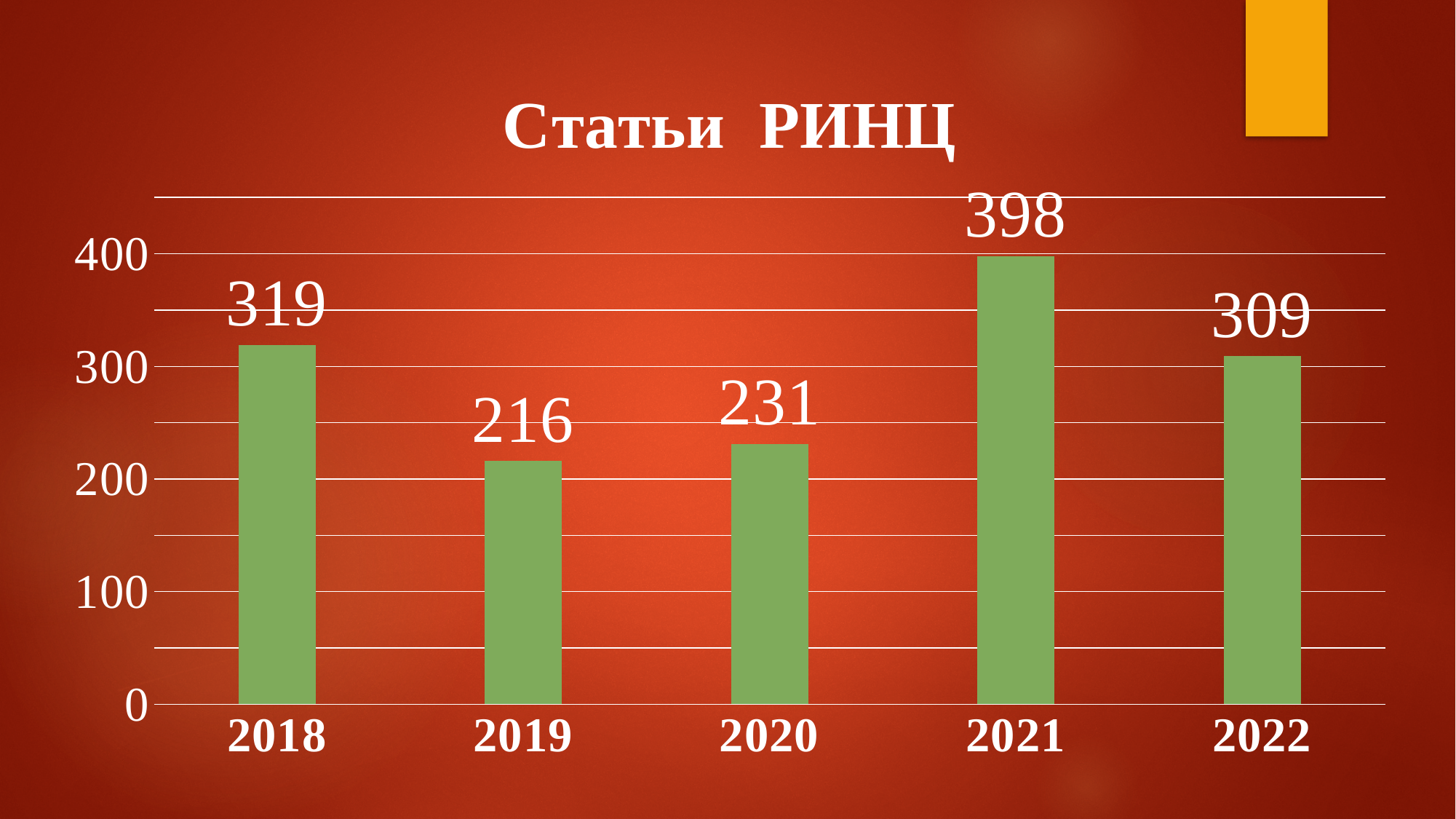
Which year has the highest value? 2021 Which is larger, the value for 2020 or the value for 2019? 2020 What is the value for 2019? 216 What is the value for 2022? 309 What is the value for 2018? 319 Which year has the lowest value? 2019 How many years are shown on the x axis? 5 Is the value for 2022 greater or less than 300? greater What is the difference between the values for 2021 and 2020? 167 What is the difference between the values for 2018 and 2022? 10 What kind of chart is this? bar chart What is the value for 2021? 398